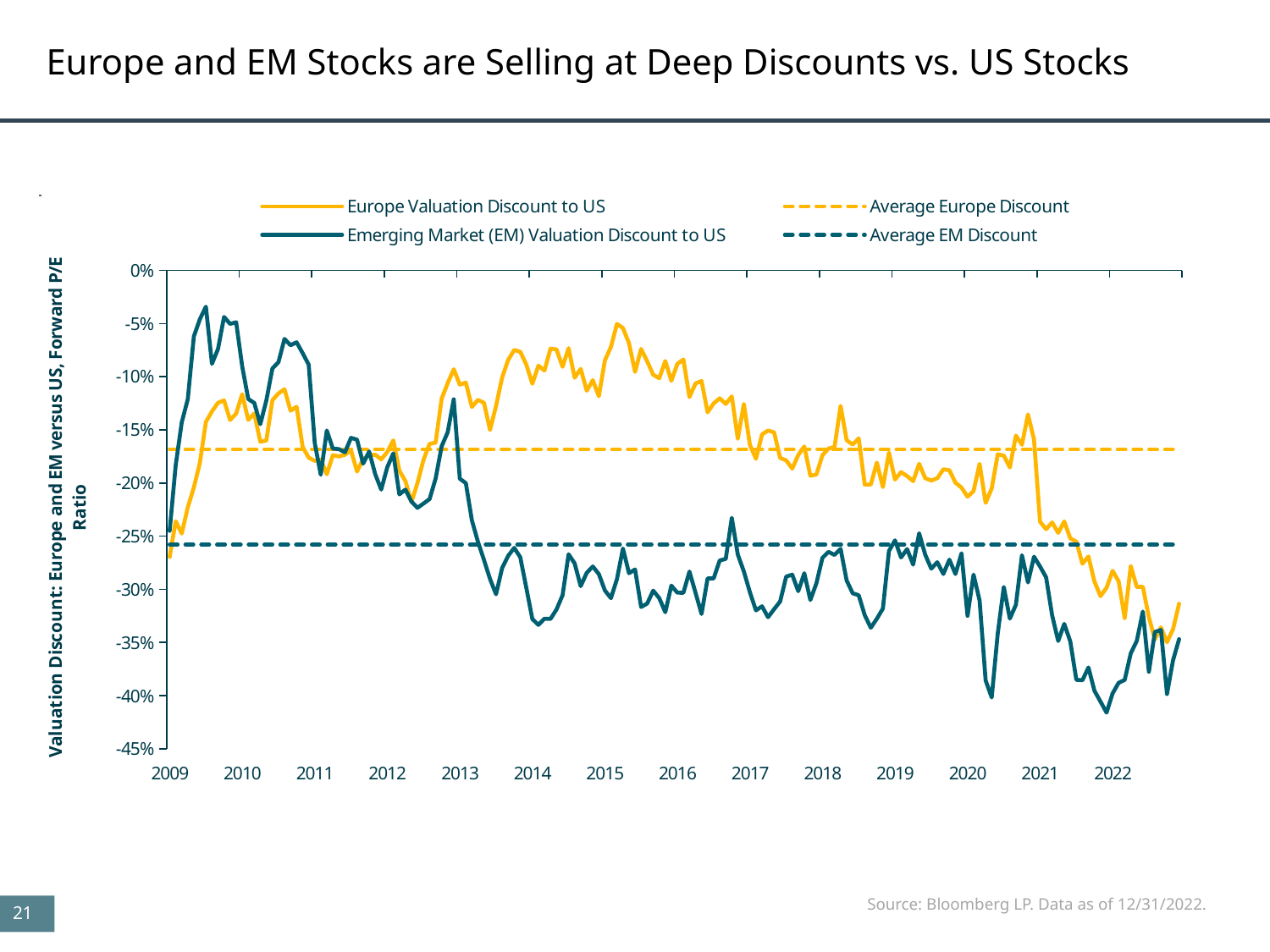
Is the Europe Valuation Discount to US at its 2015 peak greater or less than -10%? greater What is the label on the vertical axis? Valuation Discount: Europe and EM versus US, Forward P/E Ratio Is the Average Europe Discount line above or below -15%? below What kind of chart is shown on the slide? Line chart In 2015, which series is higher, Europe Valuation Discount to US or Emerging Market (EM) Valuation Discount to US? Europe Valuation Discount to US Does the Europe Valuation Discount to US line generally rise or fall from 2015 to 2022? fall What is the title of the slide's chart? Europe and EM Stocks are Selling at Deep Discounts vs. US Stocks Is the Emerging Market (EM) Valuation Discount to US at the end of 2022 greater or less than -30%? less Which dashed average line sits higher on the chart, Average Europe Discount or Average EM Discount? Average Europe Discount How many year labels are shown on the x axis? 14 How many series does the legend list? 4